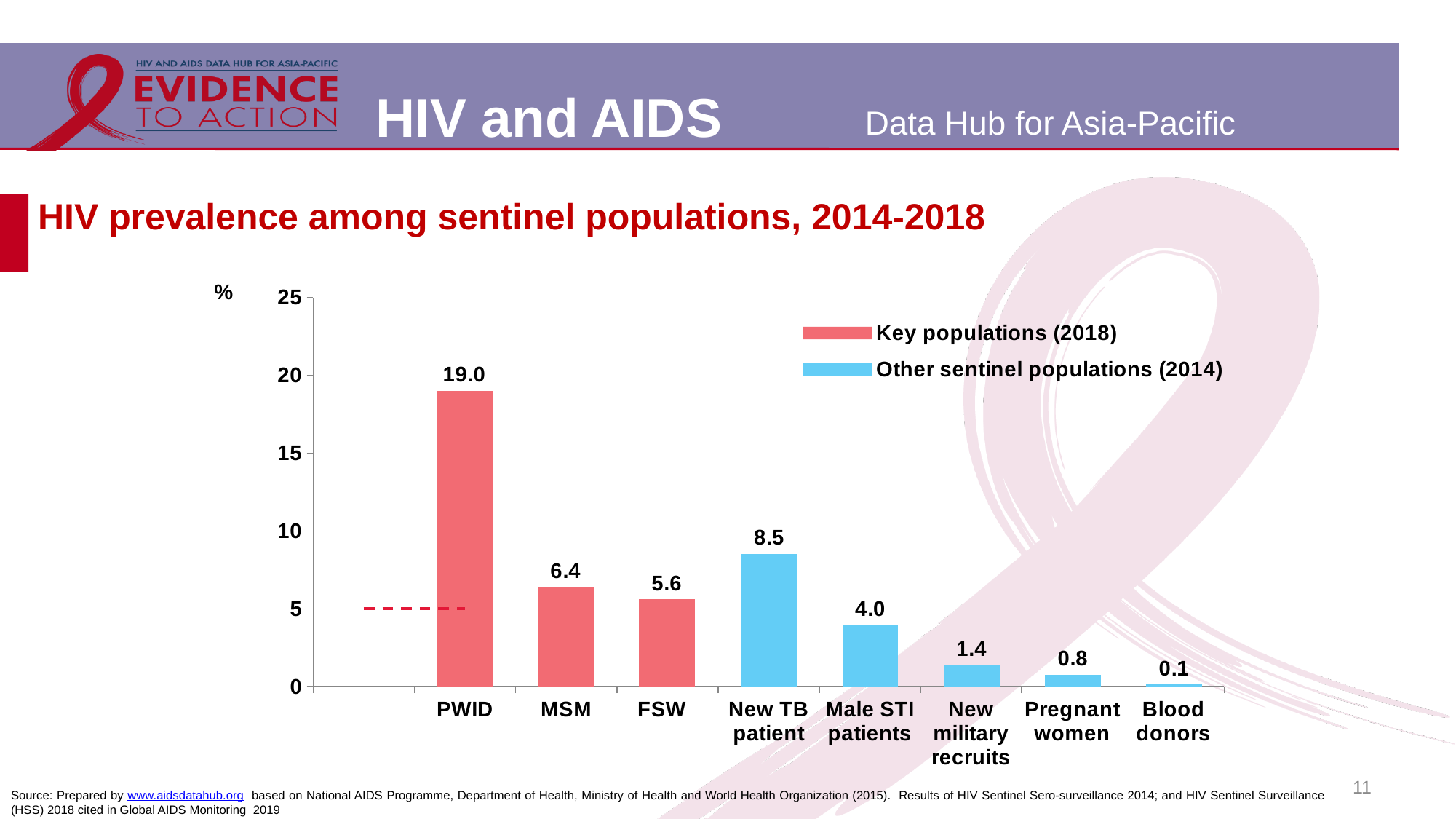
What is the HIV prevalence among new TB patients? 8.5 Which legend entry is shown in blue? Other sentinel populations (2014) Which sentinel population has the lowest HIV prevalence? Blood donors Which sentinel population has the highest HIV prevalence? PWID How many sentinel populations are shown on the x axis? 8 Is the HIV prevalence for PWID greater or less than 15? greater How many series does the legend list? 2 What is the HIV prevalence among PWID? 19.0 What kind of chart is shown on the slide? Bar chart What is the HIV prevalence among pregnant women? 0.8 Which has a higher HIV prevalence, new TB patients or male STI patients? New TB patient What is the difference in HIV prevalence between MSM and FSW? 0.8